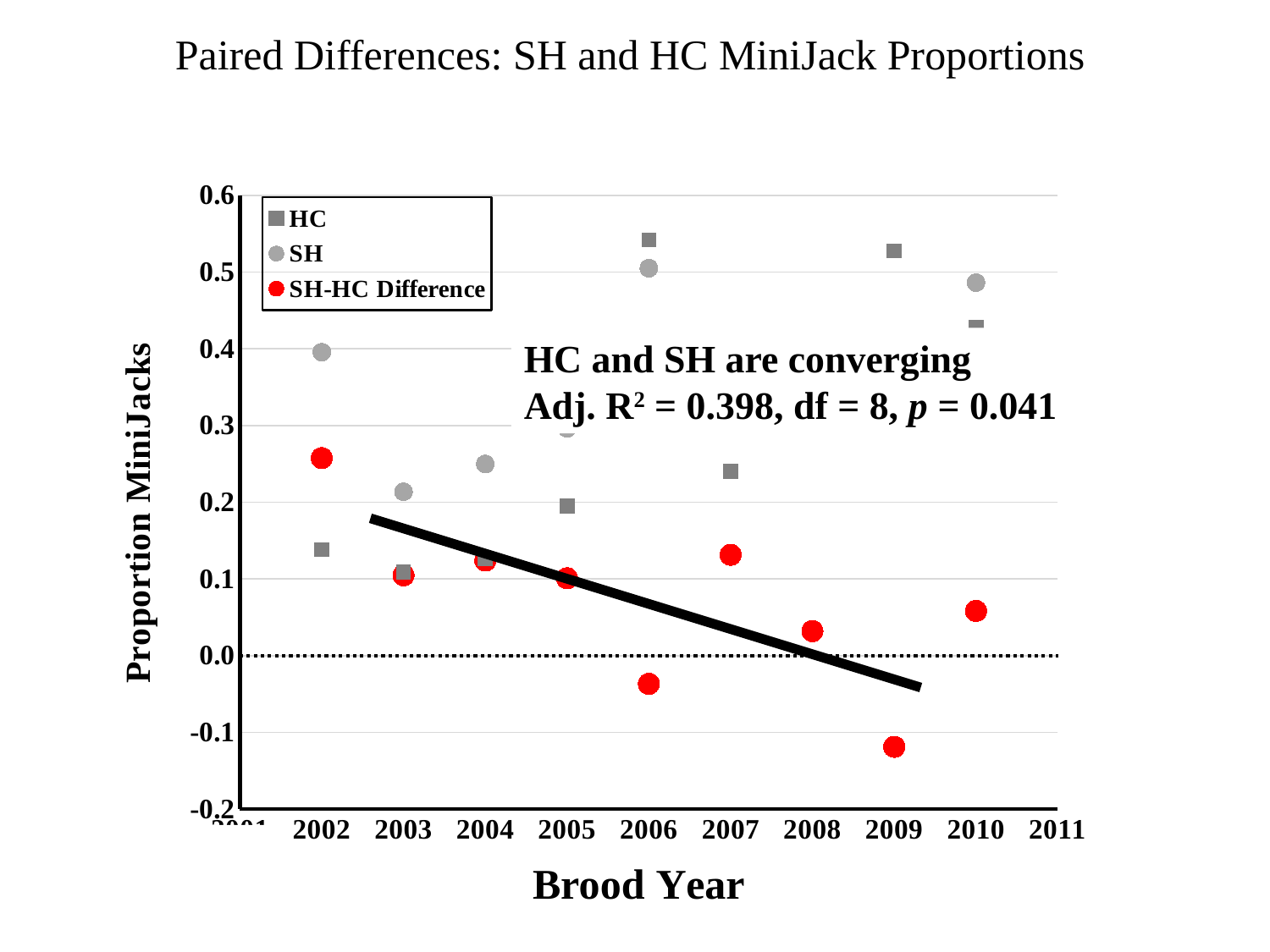
Is the HC value for brood year 2002 greater or less than 0.2? less What kind of chart is shown on the slide? Scatter chart Is the HC value for brood year 2006 greater or less than 0.5? greater For brood year 2002, which is larger, the SH value or the HC value? SH In which brood year is the SH-HC Difference highest? 2002 What are the three series named in the legend? HC, SH, SH-HC Difference In which brood year is the SH-HC Difference lowest? 2009 What is the title of the chart? Paired Differences: SH and HC MiniJack Proportions How many series does the legend list? 3 Does the fitted trend line for the SH-HC Difference rise or fall across brood years? Fall Is the SH-HC Difference value for brood year 2009 greater or less than 0.0? less